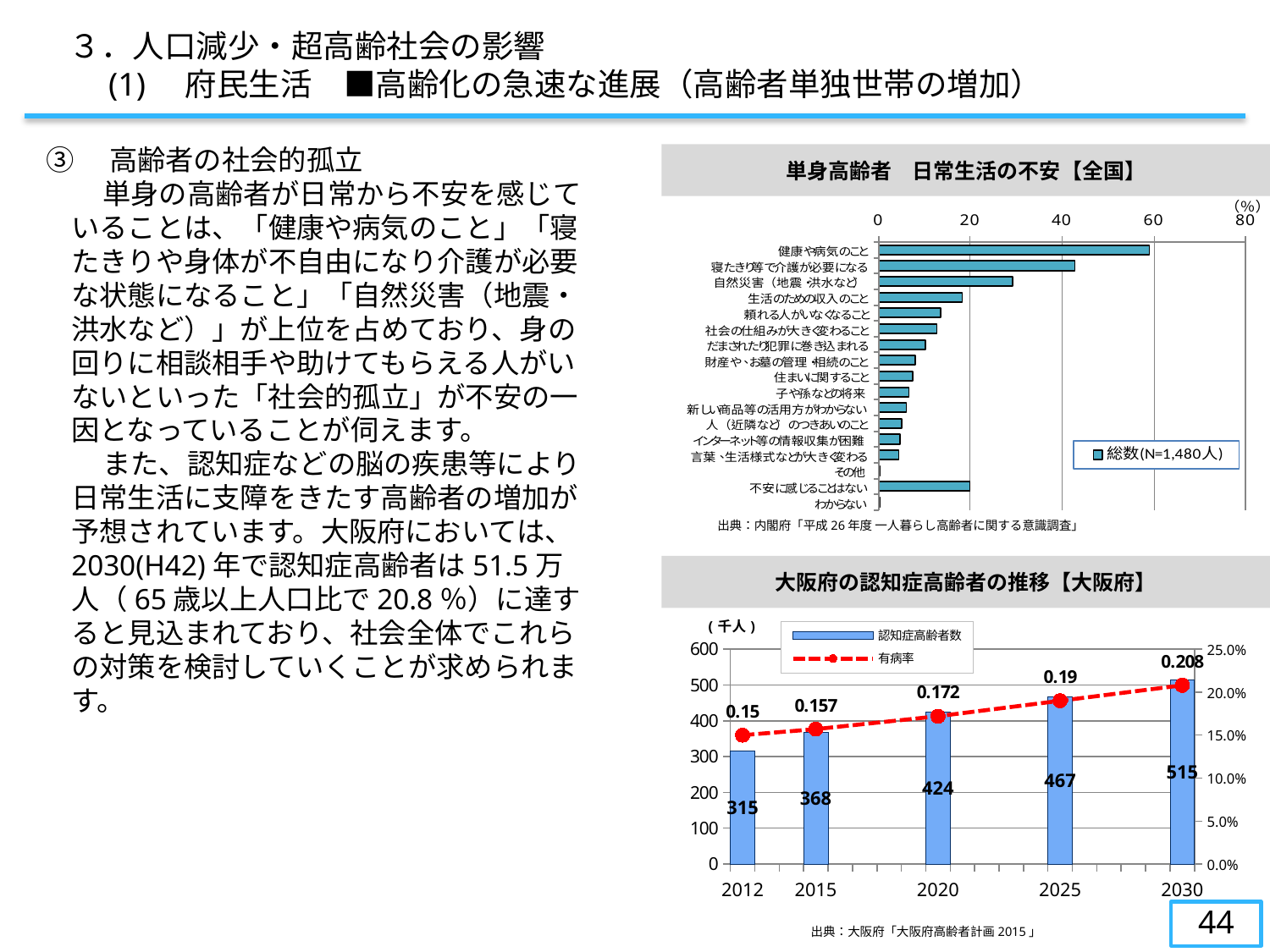
In the chart titled 大阪府の認知症高齢者の推移【大阪府】, is the 認知症高齢者数 larger in 2015 or in 2025? 2025 In the chart titled 大阪府の認知症高齢者の推移【大阪府】, how many years are plotted on the x axis? 5 In the chart titled 大阪府の認知症高齢者の推移【大阪府】, what is the value of 認知症高齢者数 for 2030? 515 In the chart titled 大阪府の認知症高齢者の推移【大阪府】, what is the value of 認知症高齢者数 for 2012? 315 In the chart titled 大阪府の認知症高齢者の推移【大阪府】, does the 認知症高齢者数 rise or fall from 2012 to 2030? rise In the chart titled 大阪府の認知症高齢者の推移【大阪府】, how many series does the legend list? 2 In the chart titled 大阪府の認知症高齢者の推移【大阪府】, which year has the lowest 有病率? 2012 In the chart titled 大阪府の認知症高齢者の推移【大阪府】, what is the 有病率 value for 2020? 0.172 In the chart titled 大阪府の認知症高齢者の推移【大阪府】, what is the difference in 認知症高齢者数 between 2030 and 2012? 200 In the chart titled 単身高齢者 日常生活の不安【全国】, is the value for 健康や病気のこと greater or less than 40? greater What kind of chart is the chart titled 単身高齢者 日常生活の不安【全国】? bar chart In the chart titled 大阪府の認知症高齢者の推移【大阪府】, which year has the highest 認知症高齢者数? 2030